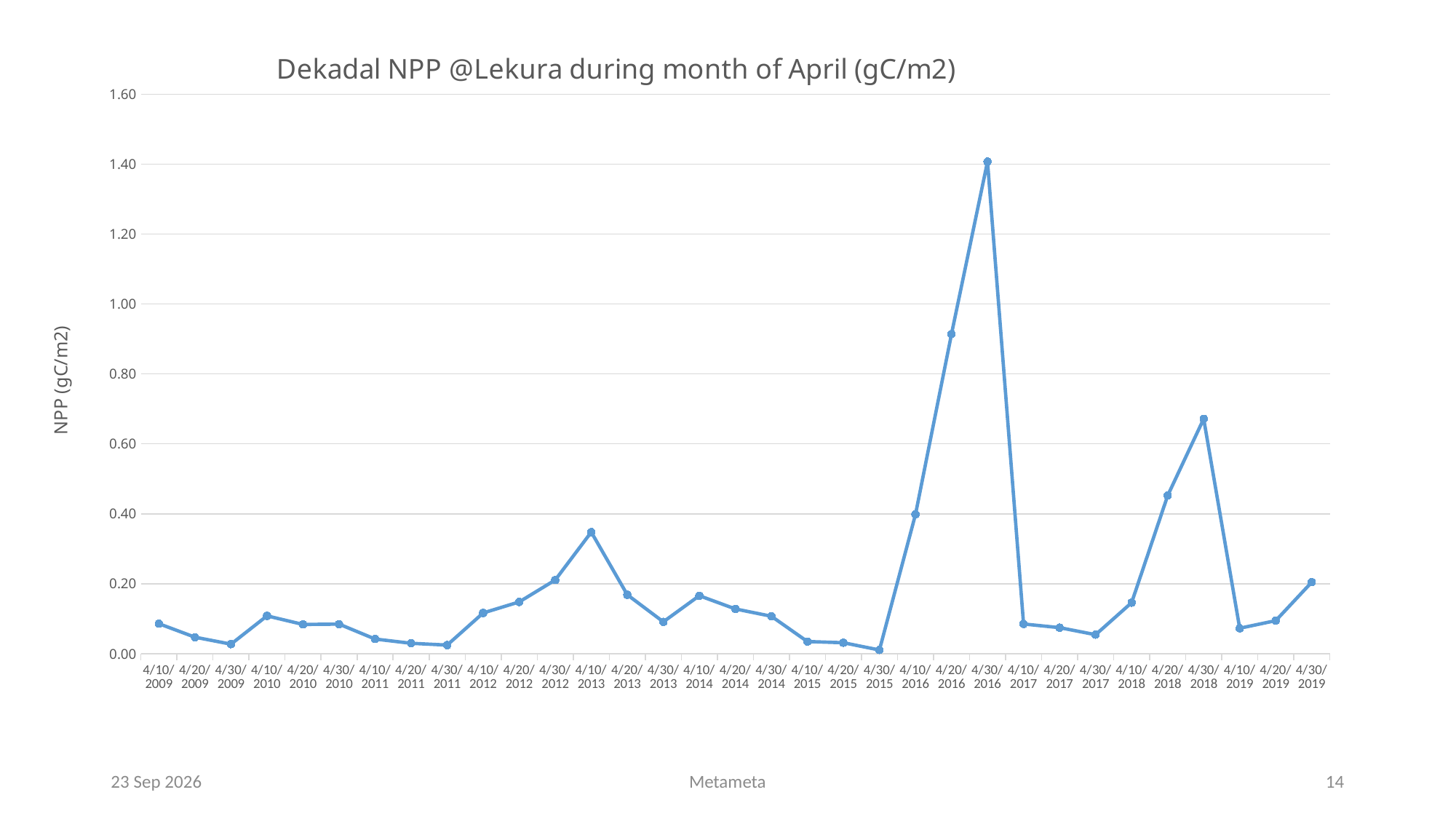
Is the value for 4/30/2016 greater or less than 1.20? greater Which date has the highest NPP value in the chart? 4/30/2016 What is the label on the vertical axis of the chart? NPP (gC/m2) Which date has the lowest NPP value in the chart? 4/30/2015 What is the title of the chart? Dekadal NPP @Lekura during month of April (gC/m2) How many data points are plotted in the chart? 33 Is the value for 4/20/2016 greater or less than 0.80? greater Is the value for 4/10/2013 greater or less than 0.40? less Do the values rise or fall from 4/10/2016 to 4/30/2016? rise What kind of chart is shown on the slide? line chart Which has the larger NPP value, 4/30/2016 or 4/30/2018? 4/30/2016